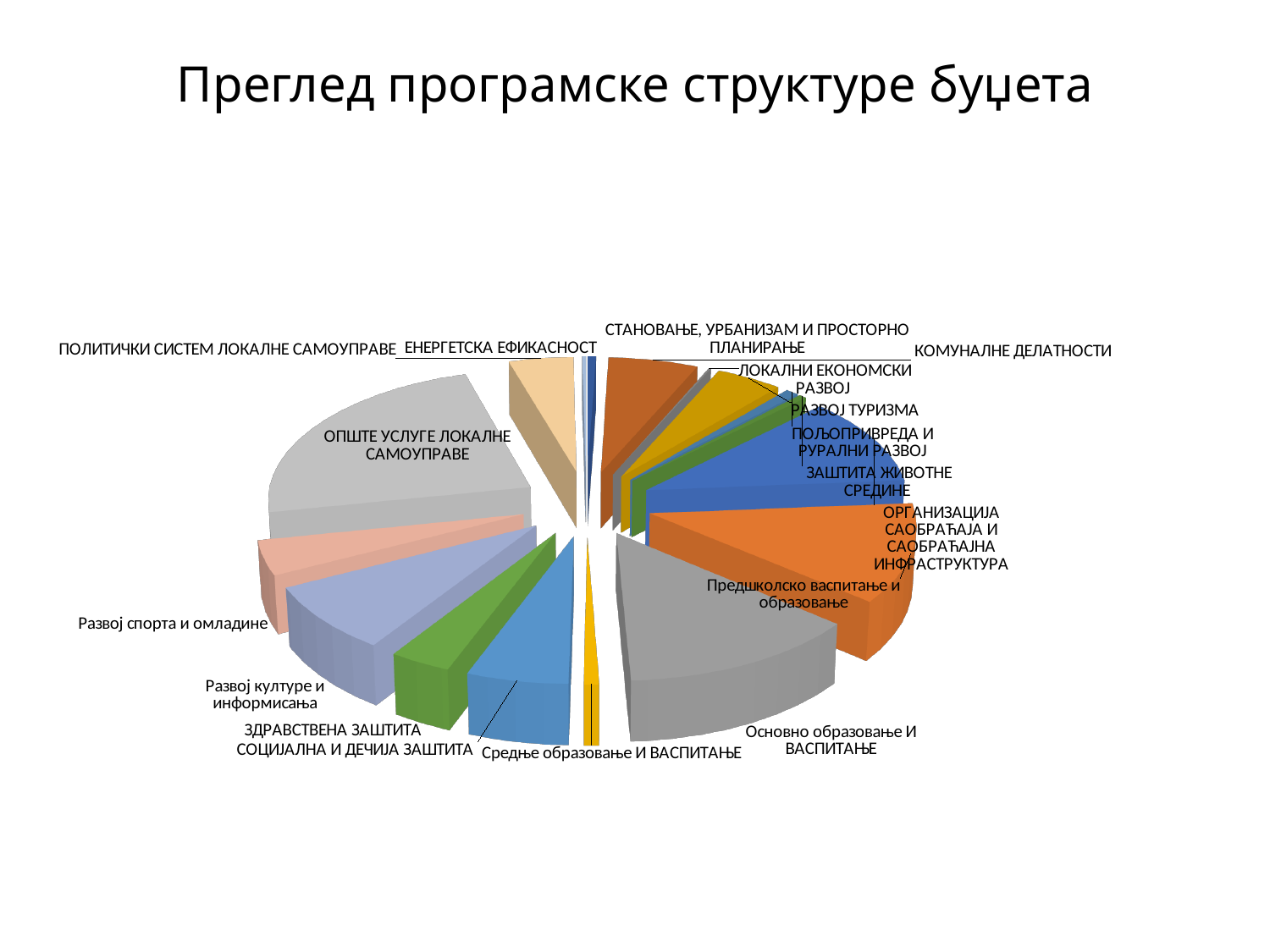
What kind of chart is shown on the slide? Pie chart Which slice is larger: Предшколско васпитање и образовање or РАЗВОЈ ТУРИЗМА? Предшколско васпитање и образовање Which slice is larger: Развој културе и информисања or ПОЛИТИЧКИ СИСТЕМ ЛОКАЛНЕ САМОУПРАВЕ? Развој културе и информисања What colour is the slice for Предшколско васпитање и образовање? Orange Which slice is larger: СОЦИЈАЛНА И ДЕЧИЈА ЗАШТИТА or ЕНЕРГЕТСКА ЕФИКАСНОСТ? СОЦИЈАЛНА И ДЕЧИЈА ЗАШТИТА How many categories (slices) are labelled in the pie chart? 17 What is the title of the slide? Преглед програмске структуре буџета